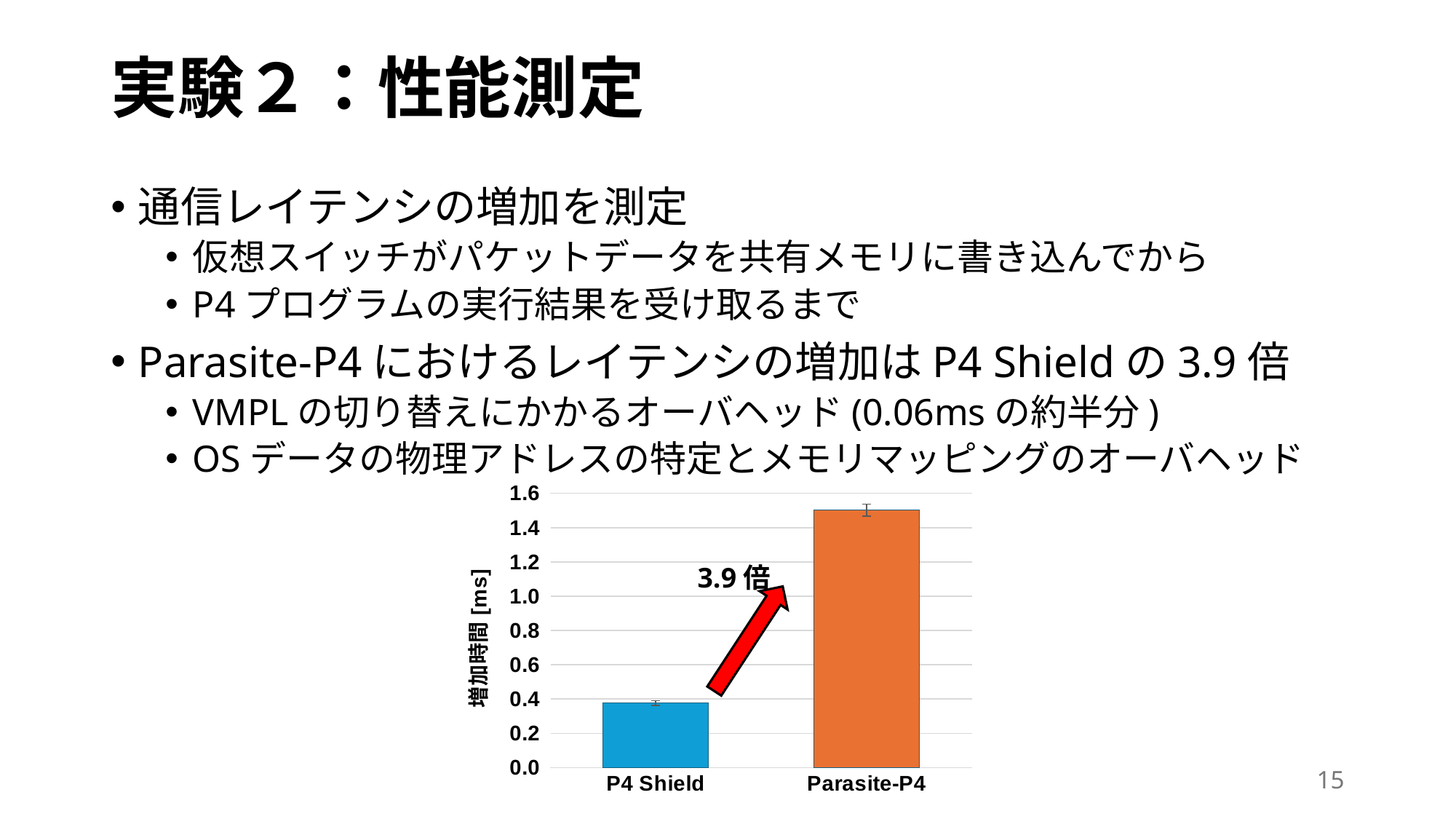
Is the value for P4 Shield greater or less than 0.2? greater Is the value for Parasite-P4 greater or less than 1.4? greater Which bar is taller, P4 Shield or Parasite-P4? Parasite-P4 Is the value for P4 Shield greater or less than 0.6? less What kind of chart is shown on the slide? bar chart What is the label of the y axis of the chart? 増加時間 [ms] How many categories are plotted on the x axis of the chart? 2 What text is written next to the red arrow in the chart? 3.9 倍 Which category has the lowest bar in the chart? P4 Shield Which category has the highest bar in the chart? Parasite-P4